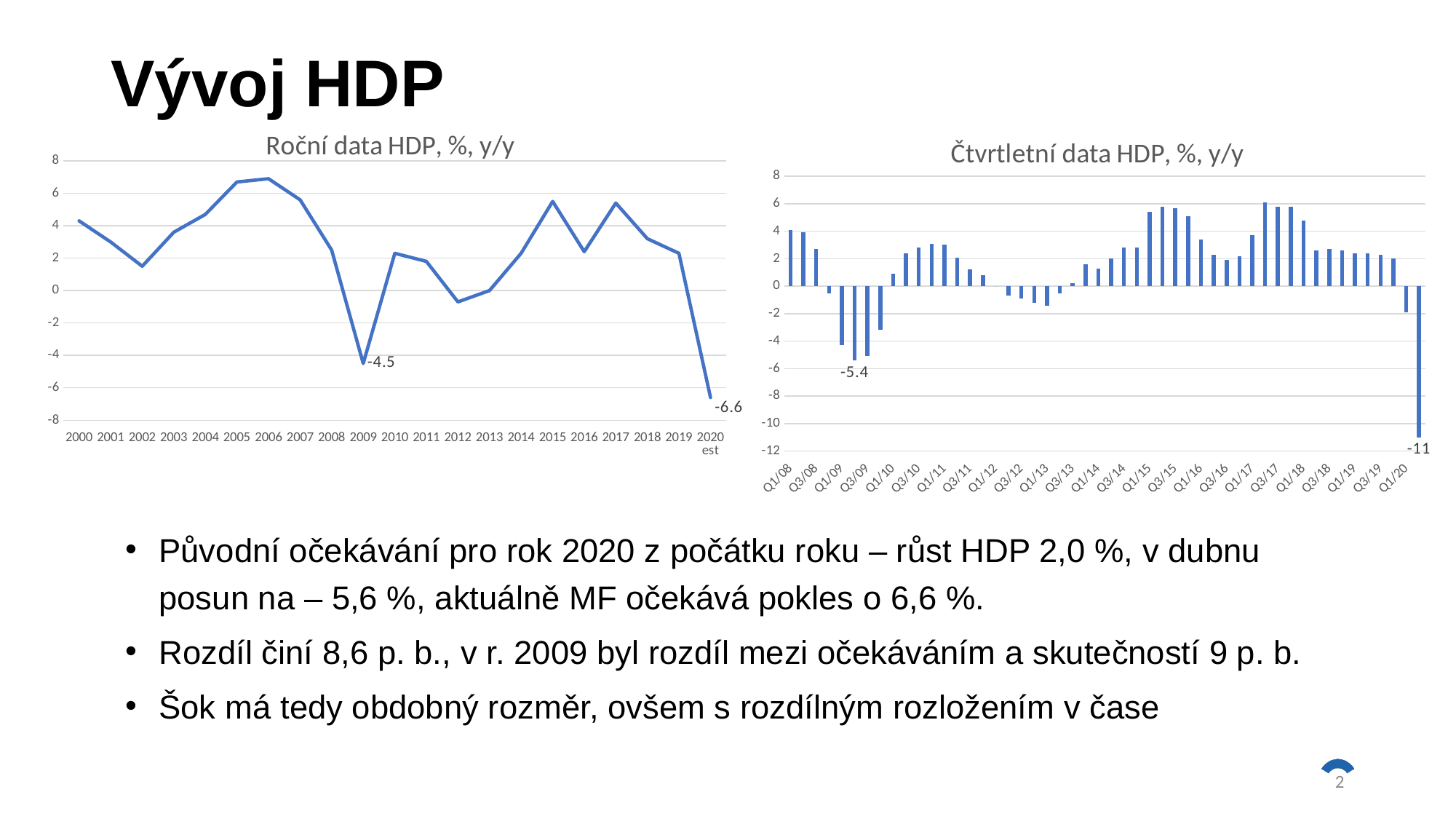
What kind of chart is the right chart titled 'Čtvrtletní data HDP, %, y/y'? bar chart In the right chart 'Čtvrtletní data HDP, %, y/y', what value is labelled on the lowest bar (the last bar, in 2020)? -11 In the left chart 'Roční data HDP, %, y/y', what is the difference between the labelled values for 2009 and 2020 est? 2.1 In the left chart 'Roční data HDP, %, y/y', is the value for 2015 greater or less than 4? greater In the left chart 'Roční data HDP, %, y/y', what value is labelled for 2009? -4.5 In the left chart 'Roční data HDP, %, y/y', which is lower, the value for 2009 or the value for 2020 est? 2020 est In the left chart 'Roční data HDP, %, y/y', do the values rise or fall from 2017 to 2020 est? fall In the left chart 'Roční data HDP, %, y/y', how many years (data points) are plotted on the x axis? 21 In the left chart 'Roční data HDP, %, y/y', which year has the lowest value? 2020 est What kind of chart is the left chart titled 'Roční data HDP, %, y/y'? line chart In the right chart 'Čtvrtletní data HDP, %, y/y', what value is labelled on the lowest bar in 2009? -5.4 In the left chart 'Roční data HDP, %, y/y', what value is labelled for 2020 est? -6.6